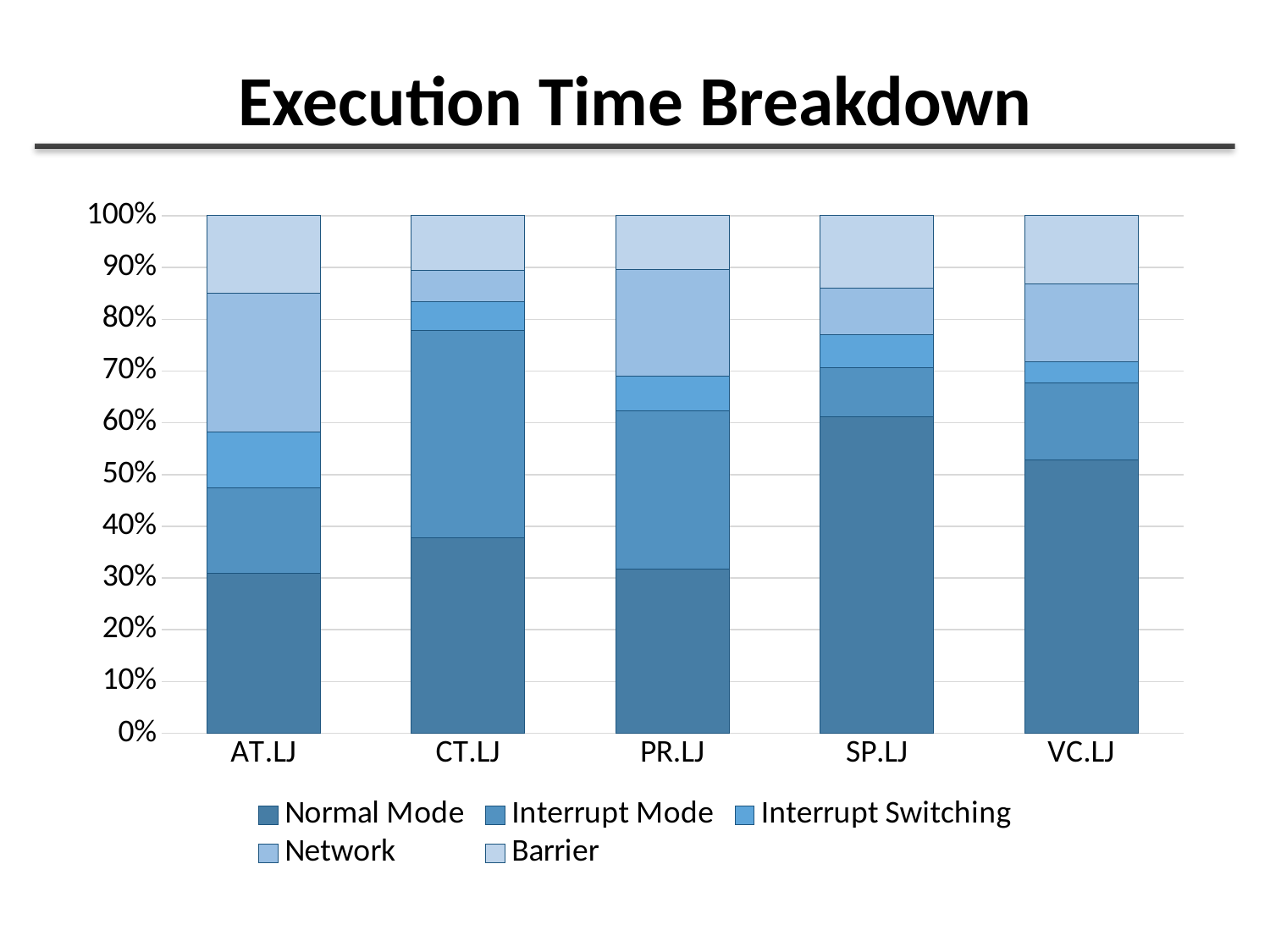
How many categories are shown along the x axis? 5 Which category has the smallest Network share? CT.LJ What kind of chart is shown on the slide? stacked bar chart Is the Normal Mode share for SP.LJ greater or less than 50%? greater How many series does the legend list? 5 Is the Normal Mode share for AT.LJ greater or less than 40%? less Which category has the largest Network share? AT.LJ What does each stacked bar total? 100% Which category has the largest Interrupt Mode share? CT.LJ Which has a larger Normal Mode share, VC.LJ or AT.LJ? VC.LJ Which category has the largest Normal Mode share? SP.LJ What is the title of the chart? Execution Time Breakdown